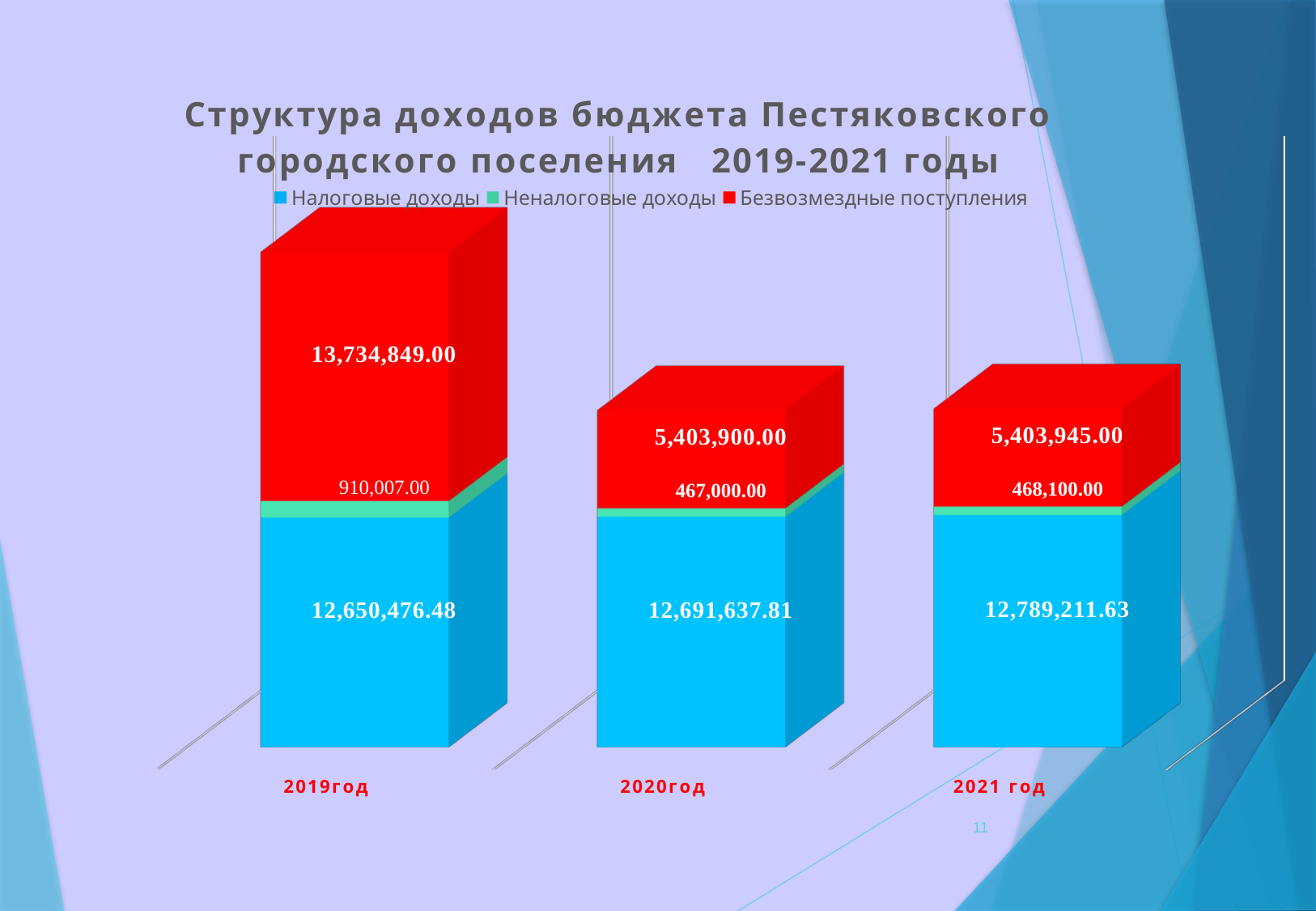
Which is larger: Налоговые доходы in 2019год or Безвозмездные поступления in 2019год? Безвозмездные поступления in 2019год What is the value of Неналоговые доходы for 2021 год? 468,100.00 How many years (categories) are shown on the x axis? 3 Do the values of Налоговые доходы rise or fall from 2019год to 2021 год? Rise How many series does the legend list? 3 What is the value of Налоговые доходы for 2019год? 12,650,476.48 In which year is Неналоговые доходы the lowest? 2020год What is the total of the stacked bar for 2020год? 18,562,537.81 In which year is Безвозмездные поступления the highest? 2019год What is the difference between Безвозмездные поступления in 2019год and 2020год? 8,330,949.00 What kind of chart is shown on the slide? Stacked bar chart What is the value of Безвозмездные поступления for 2020год? 5,403,900.00